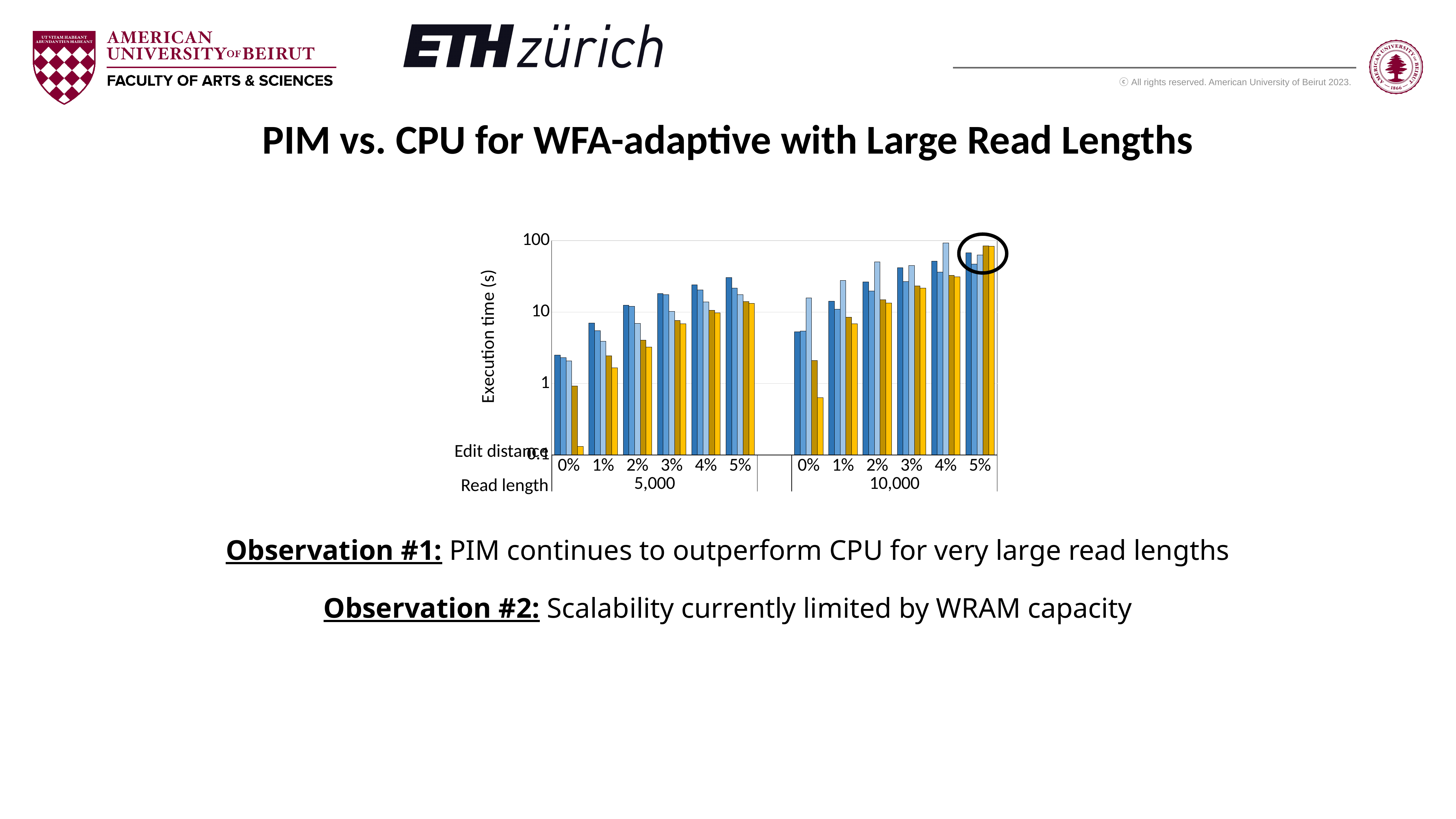
Is the tallest bar for 5% edit distance at read length 5,000 greater or less than 10? greater What is the title of the slide containing the chart? PIM vs. CPU for WFA-adaptive with Large Read Lengths Is the shortest bar for 0% edit distance at read length 5,000 greater or less than 1? less What is the label of the y axis of the chart? Execution time (s) Is the tallest bar for 5% edit distance at read length 10,000 greater or less than 10? greater How many read length groups are shown on the x axis of the chart? 2 What kind of chart is shown on the slide? bar chart For read length 5,000, do the execution times of the dark blue bars rise or fall as edit distance increases from 0% to 5%? rise How many edit distance categories are shown for each read length in the chart? 6 What is the highest value shown on the y axis of the chart? 100 At 5% edit distance, which read length group has the taller bars: 5,000 or 10,000? 10,000